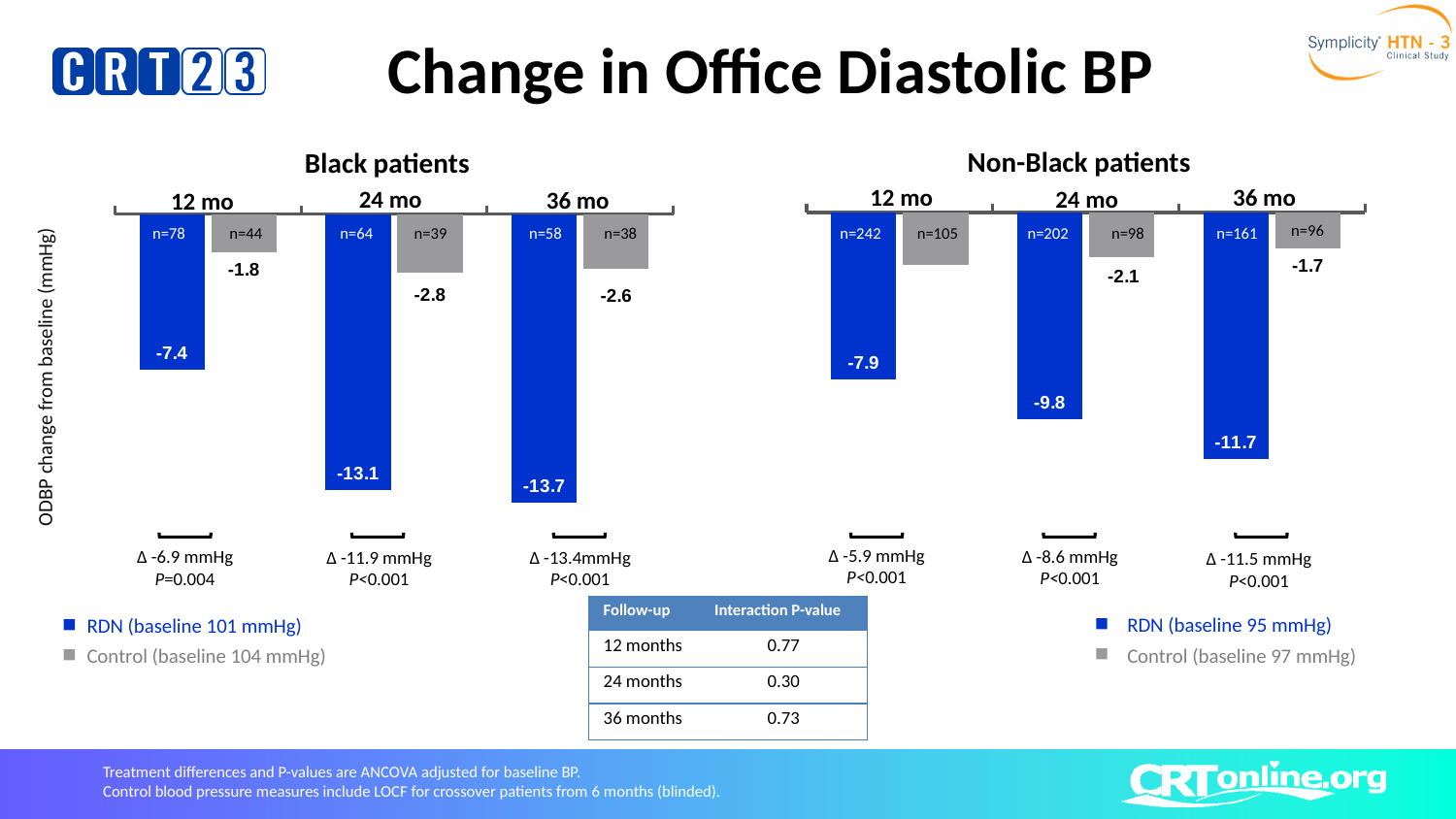
In the Black patients chart, what is the ODBP change from baseline for RDN at 12 mo? -7.4 In the Non-Black patients chart, do the RDN values rise or fall from 12 mo to 36 mo? fall What kind of chart is used for the Black patients data? bar chart In the Black patients chart, what is the ODBP change from baseline for Control at 24 mo? -2.8 In the Black patients chart, what is the difference between the RDN change at 24 mo and at 12 mo? 5.7 How many series does the legend of the Black patients chart list? 2 In the Black patients chart, at which time point is the RDN change from baseline lowest (most negative)? 36 mo According to the legend of the Black patients chart, what is the RDN baseline value? 101 mmHg In the Non-Black patients chart, which RDN bar shows the larger reduction, 24 mo or 36 mo? 36 mo In the Non-Black patients chart, what is the ODBP change from baseline for RDN at 36 mo? -11.7 How many follow-up time points are shown in the Non-Black patients chart? 3 In the Non-Black patients chart, what is the ODBP change from baseline for Control at 24 mo? -2.1